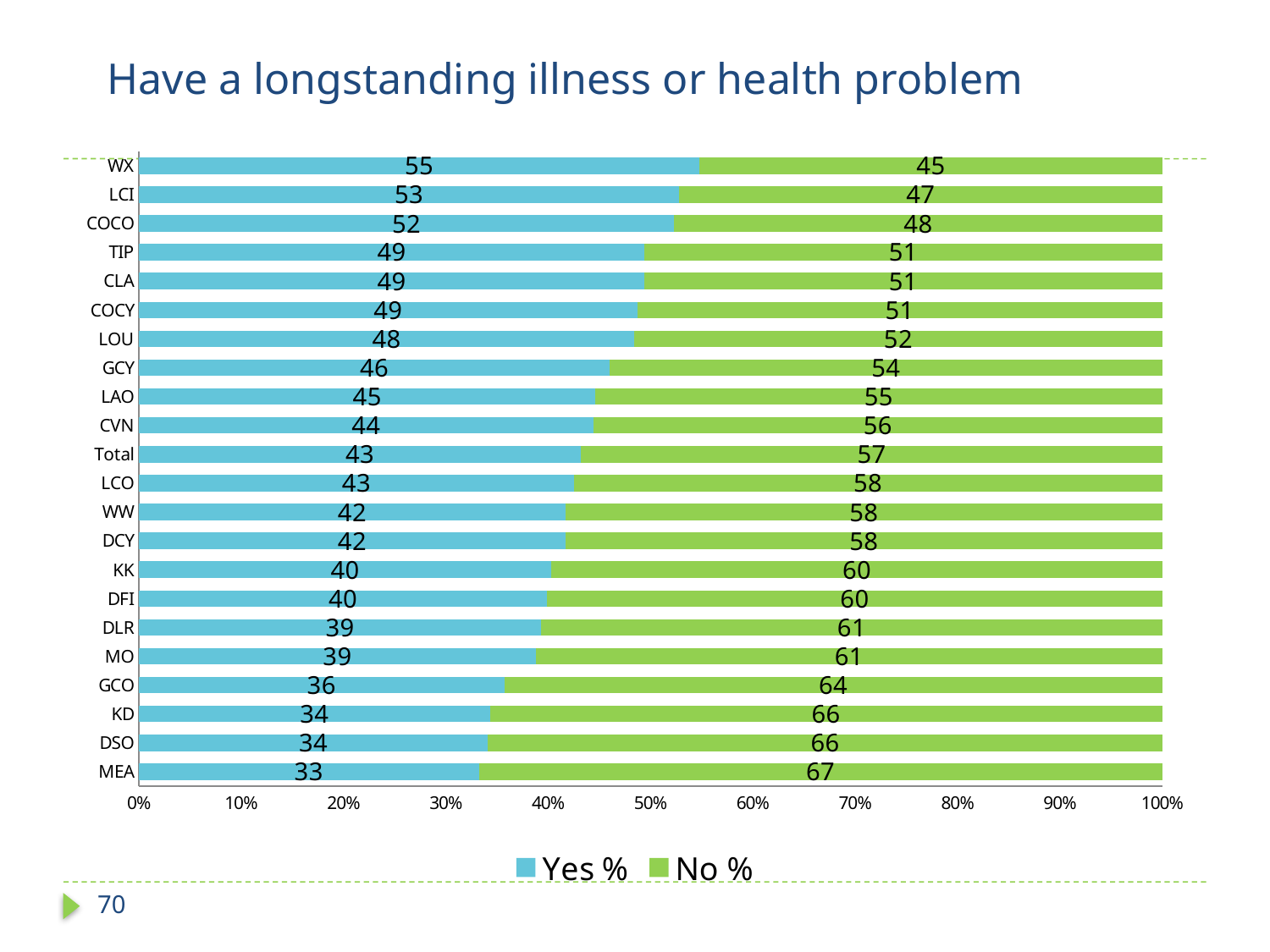
Which category has the highest Yes % value? WX What is the title of the chart? Have a longstanding illness or health problem What is the No % value for MEA? 67 What kind of chart is shown on the slide? Stacked bar chart What is the Yes % value for WX? 55 Is the Yes % value for KD greater or less than 40%? less What is the Yes % value for Total? 43 How many series does the legend list? 2 What is the difference between the Yes % values for WX and MEA? 22 Which is larger, the Yes % value for GCO or the Yes % value for LOU? LOU Which category has the lowest Yes % value? MEA How many categories are shown on the chart? 22